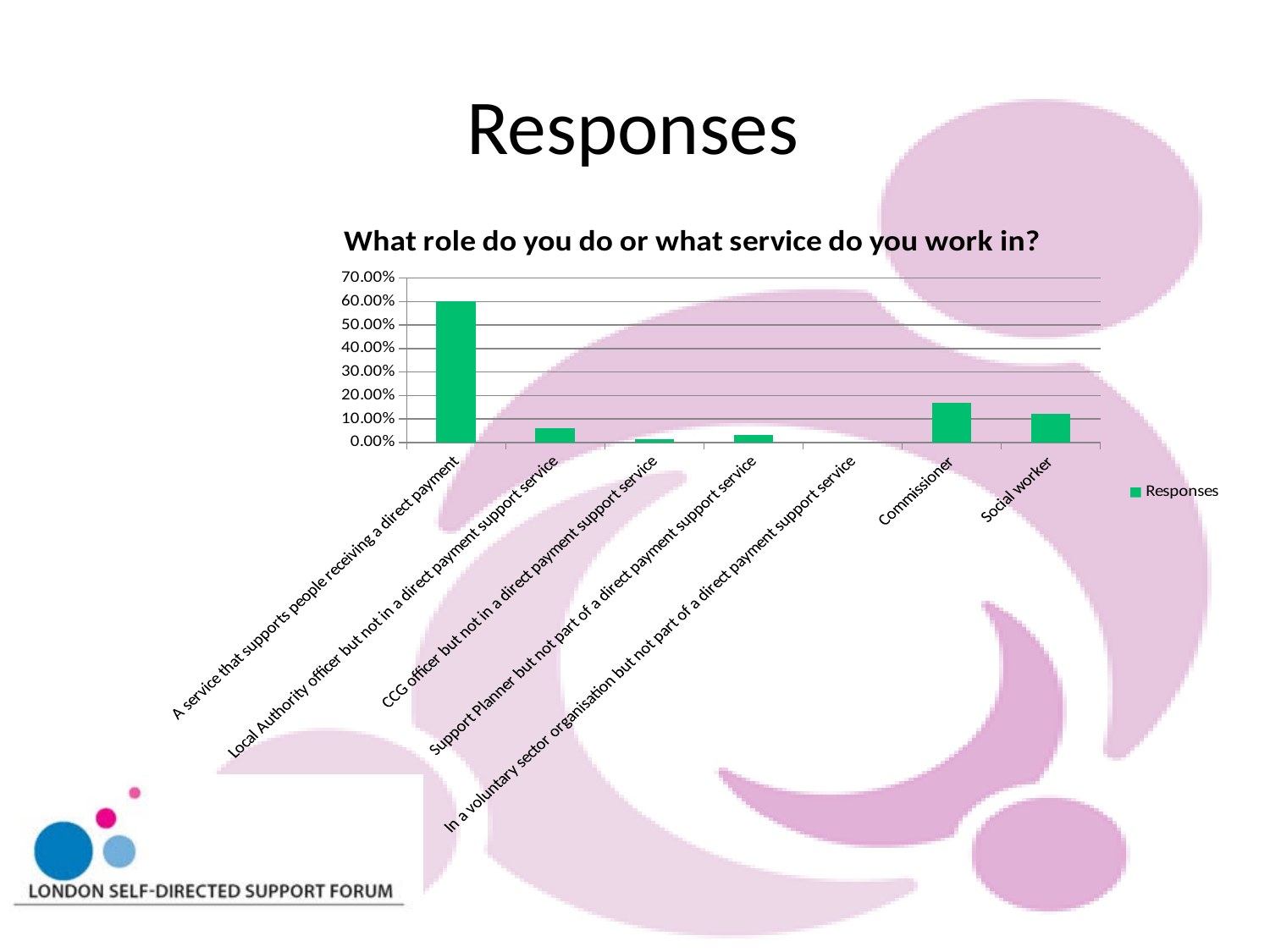
What kind of chart is shown on the slide? bar chart Is the value for Commissioner greater or less than 10.00%? greater How many categories are shown on the x axis of the chart? 7 Is the value for 'A service that supports people receiving a direct payment' greater or less than 50.00%? greater Is the value for Commissioner greater or less than 20.00%? less Which has the larger value, Social worker or 'Support Planner but not part of a direct payment support service'? Social worker What is the name of the series shown in the legend? Responses What is the title of the chart? What role do you do or what service do you work in? Which category has the highest value in the chart? A service that supports people receiving a direct payment Which has the larger value, Commissioner or Social worker? Commissioner How many series does the chart legend list? 1